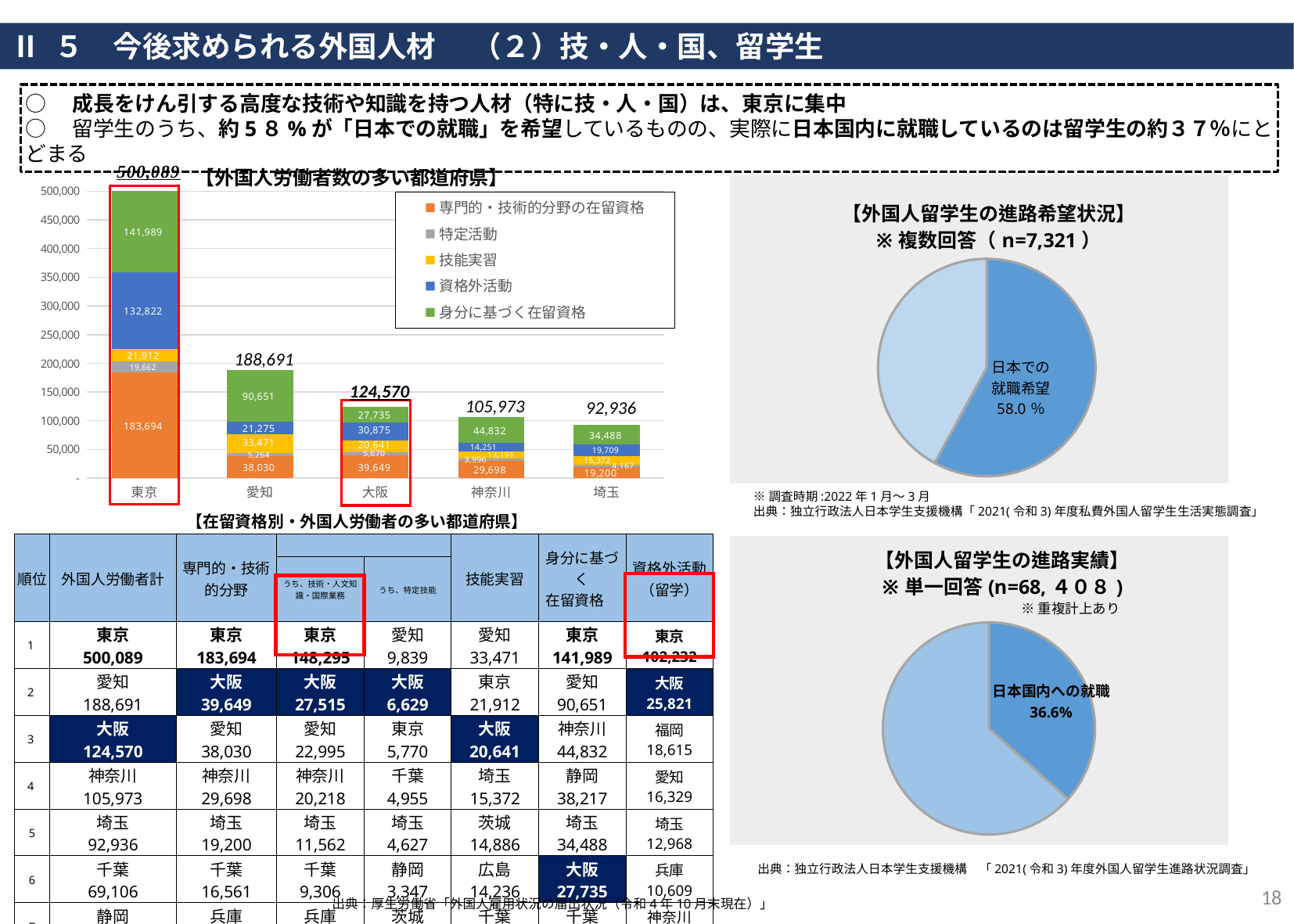
In the 【外国人労働者数の多い都道府県】 bar chart, what is the value of 身分に基づく在留資格 for 愛知? 90,651 What kind of chart is the 【外国人労働者数の多い都道府県】 chart on the left? bar chart In the 【外国人労働者数の多い都道府県】 bar chart, which has the larger total, 大阪 or 神奈川? 大阪 How many series does the legend of the 【外国人労働者数の多い都道府県】 bar chart list? 5 In the 【外国人労働者数の多い都道府県】 bar chart, which prefecture has the highest total? 東京 In the 【外国人労働者数の多い都道府県】 bar chart, what is the total number of foreign workers for 東京? 500,089 In the 【外国人労働者数の多い都道府県】 bar chart, what is the difference between the totals for 東京 and 愛知? 311,398 How many prefectures are shown on the x axis of the 【外国人労働者数の多い都道府県】 bar chart? 5 In the 【外国人留学生の進路希望状況】 pie chart, what share is labelled 日本での就職希望? 58.0 % In the 【外国人労働者数の多い都道府県】 bar chart, do the totals rise or fall from left to right along the x axis? fall In the 【外国人労働者数の多い都道府県】 bar chart, which prefecture has the lowest total? 埼玉 In the 【外国人労働者数の多い都道府県】 bar chart, what is the value of 技能実習 for 大阪? 20,641